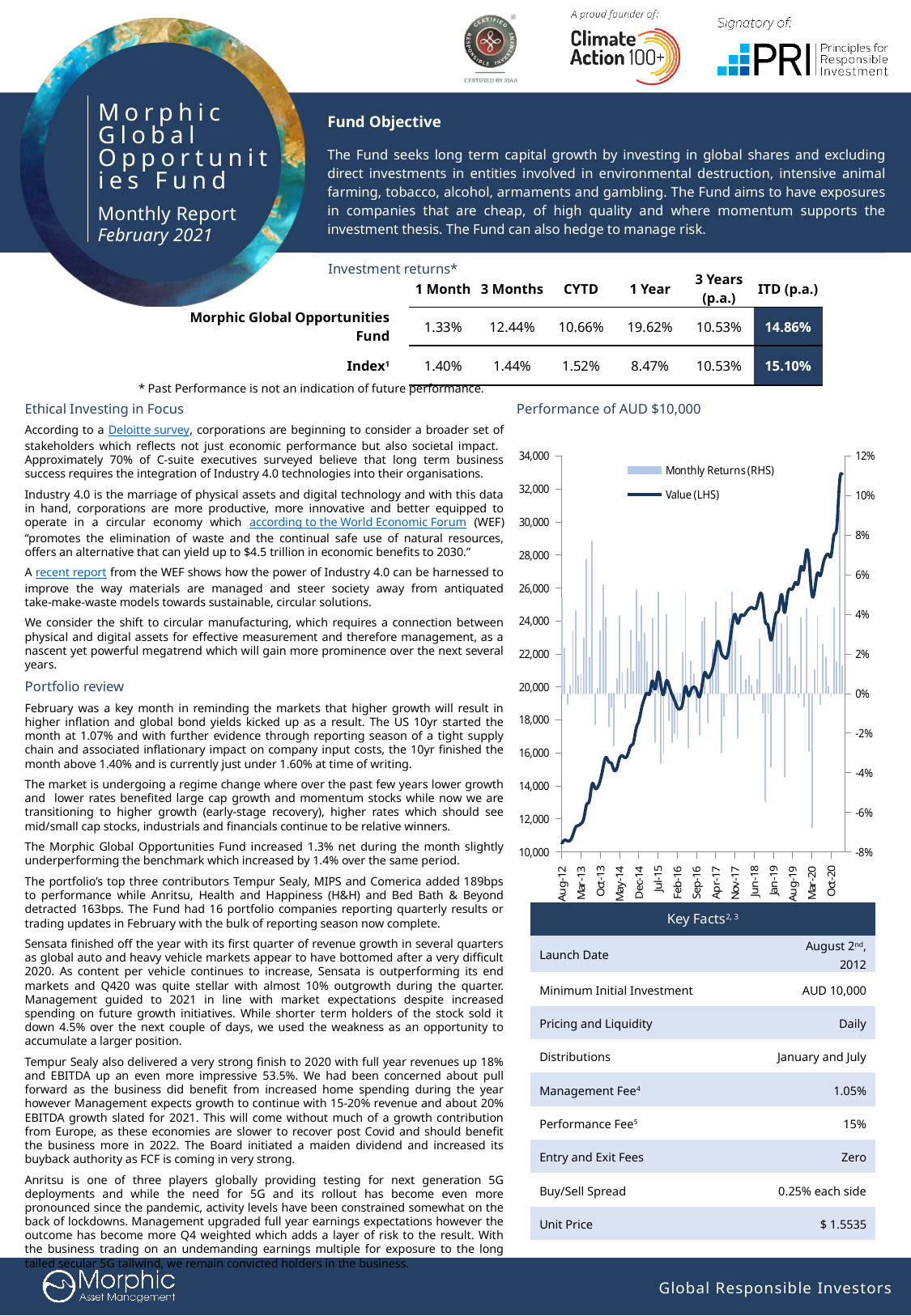
Does the Value (LHS) line in the "Performance of AUD $10,000" chart generally rise or fall from Aug-12 to Oct-20? Rise In the "Performance of AUD $10,000" chart, is the Value (LHS) at Aug-12 greater or less than 12,000? less How many date labels are shown along the x axis of the "Performance of AUD $10,000" chart? 15 In the "Performance of AUD $10,000" chart, is the Value (LHS) at Dec-14 greater or less than 14,000? greater How many series does the legend of the "Performance of AUD $10,000" chart list? 2 What kind of chart is the "Performance of AUD $10,000" chart? A combined line and bar chart In the "Performance of AUD $10,000" chart, is the Value (LHS) at the end of the series (after Oct-20) greater or less than 30,000? greater What are the two series named in the legend of the "Performance of AUD $10,000" chart? Monthly Returns (RHS) and Value (LHS) In the "Performance of AUD $10,000" chart, which series is plotted as bars? Monthly Returns (RHS) What is the highest value shown on the left-hand axis of the "Performance of AUD $10,000" chart? 34,000